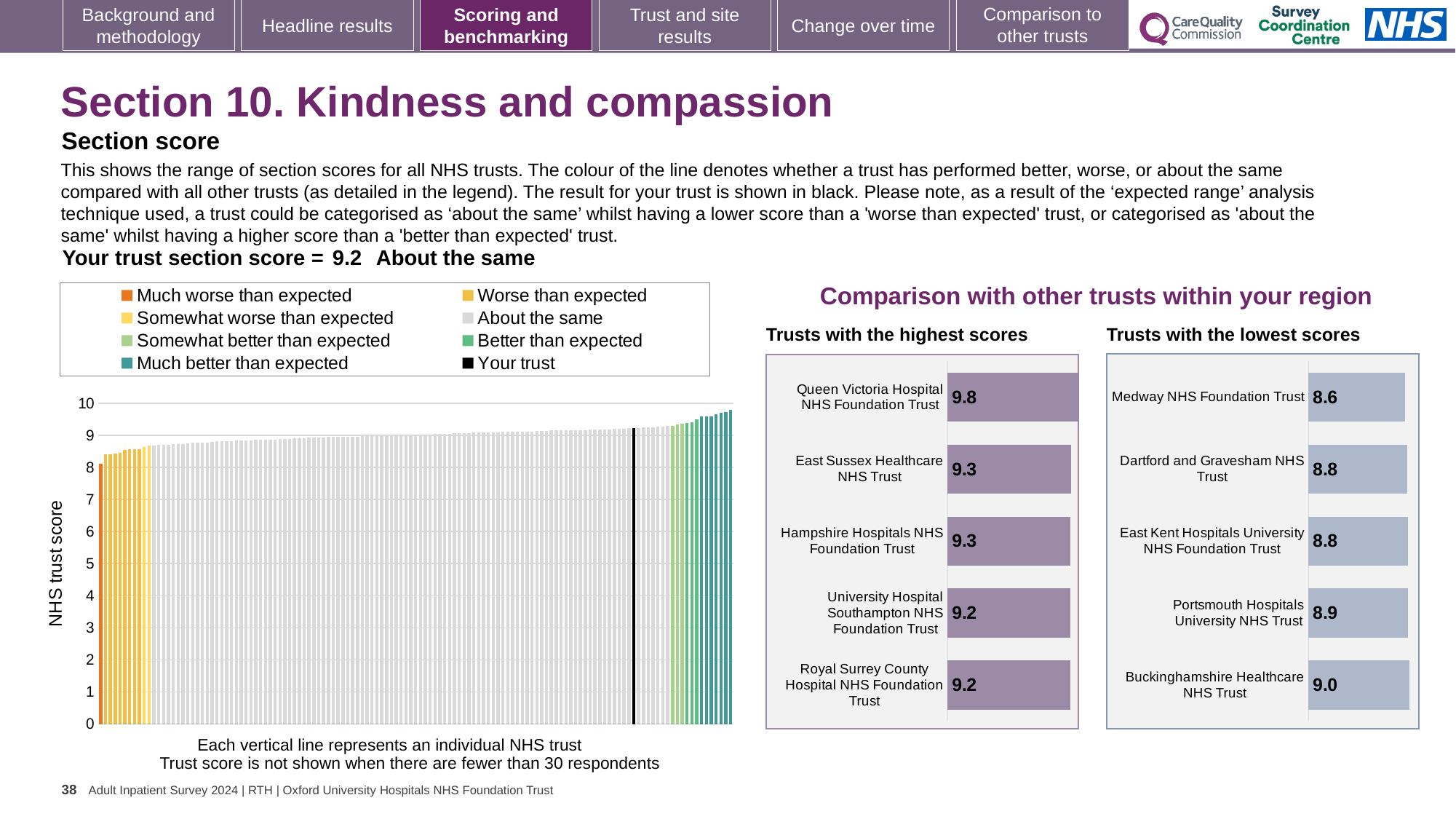
How many entries does the legend of the NHS trust score chart on the left list? 8 Comparing the two regional charts, which has the higher score: Hampshire Hospitals NHS Foundation Trust or Portsmouth Hospitals University NHS Trust? Hampshire Hospitals NHS Foundation Trust In the 'Trusts with the lowest scores' chart, what is the difference between the scores of Buckinghamshire Healthcare NHS Trust and Medway NHS Foundation Trust? 0.4 In the NHS trust score chart on the left, do the values rise or fall from left to right? Rise In the 'Trusts with the highest scores' chart, what is the score for Queen Victoria Hospital NHS Foundation Trust? 9.8 In the 'Trusts with the highest scores' chart, what is the difference between the scores of Queen Victoria Hospital NHS Foundation Trust and Royal Surrey County Hospital NHS Foundation Trust? 0.6 What kind of chart is the NHS trust score chart on the left of the slide? Bar chart In the 'Trusts with the lowest scores' chart, what is the score for Medway NHS Foundation Trust? 8.6 In the 'Trusts with the lowest scores' chart, which trust has the lowest score? Medway NHS Foundation Trust How many trusts are listed in the 'Trusts with the highest scores' chart? 5 In the NHS trust score chart on the left, is the value of the leftmost bar greater or less than 9? less In the 'Trusts with the highest scores' chart, which trust has the highest score? Queen Victoria Hospital NHS Foundation Trust